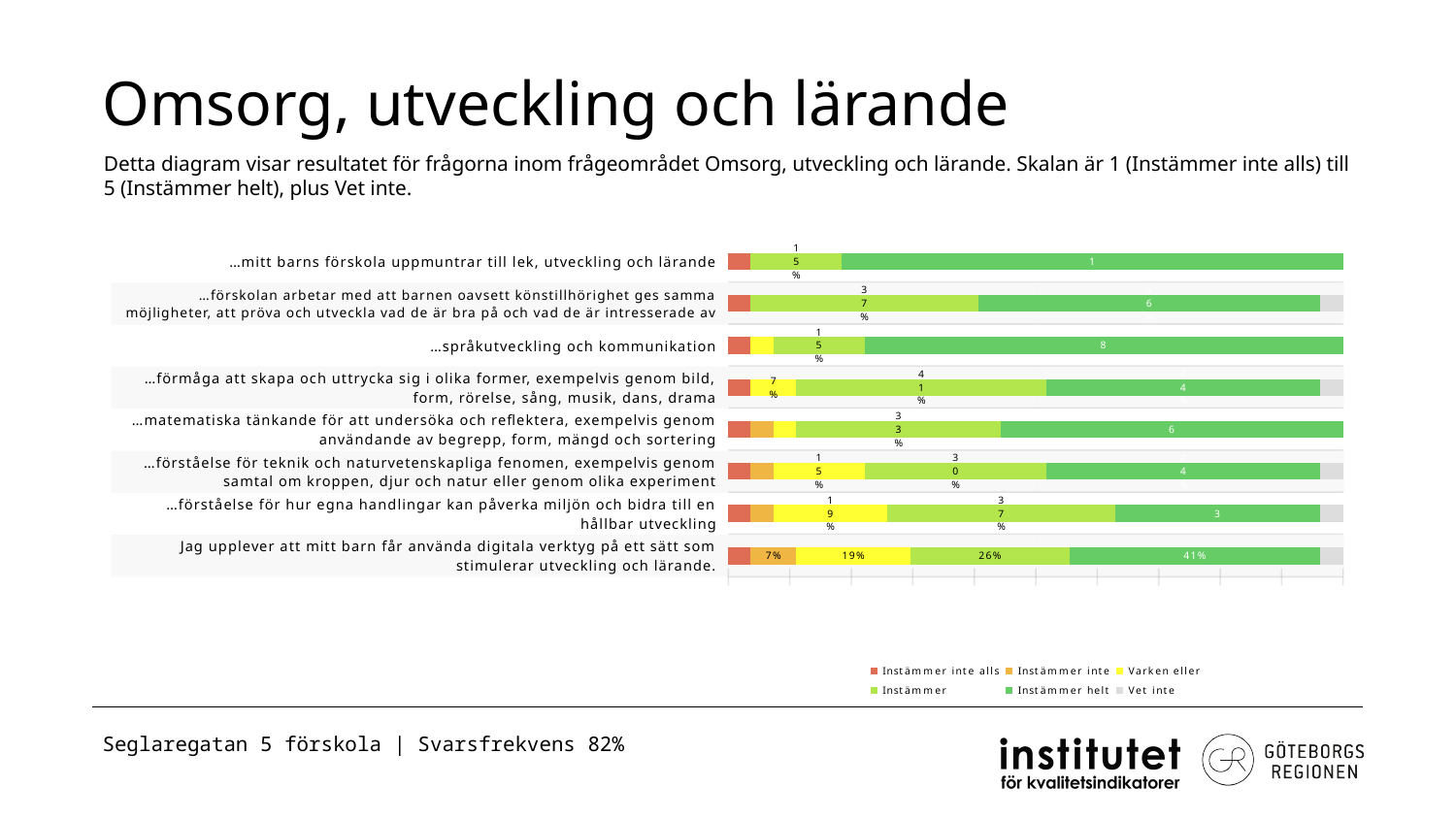
How many question categories are plotted in the chart? 8 What is the title of the slide containing the chart? Omsorg, utveckling och lärande For the category "Jag upplever att mitt barn får använda digitala verktyg på ett sätt som stimulerar utveckling och lärande.", what is the value for Varken eller? 19% In the bar for "Jag upplever att mitt barn får använda digitala verktyg...", which is larger: Instämmer helt or Varken eller? Instämmer helt In the bar for "Jag upplever att mitt barn får använda digitala verktyg...", what is the difference between the Instämmer helt value and the Instämmer value? 15% For the category "Jag upplever att mitt barn får använda digitala verktyg på ett sätt som stimulerar utveckling och lärande.", what is the value for Instämmer helt? 41% How many series does the legend list? 6 What kind of chart is shown on the slide? bar chart For the category "Jag upplever att mitt barn får använda digitala verktyg på ett sätt som stimulerar utveckling och lärande.", what is the value for Instämmer? 26% What colour represents Vet inte in the legend? grey Which category has the largest Instämmer helt segment? …mitt barns förskola uppmuntrar till lek, utveckling och lärande